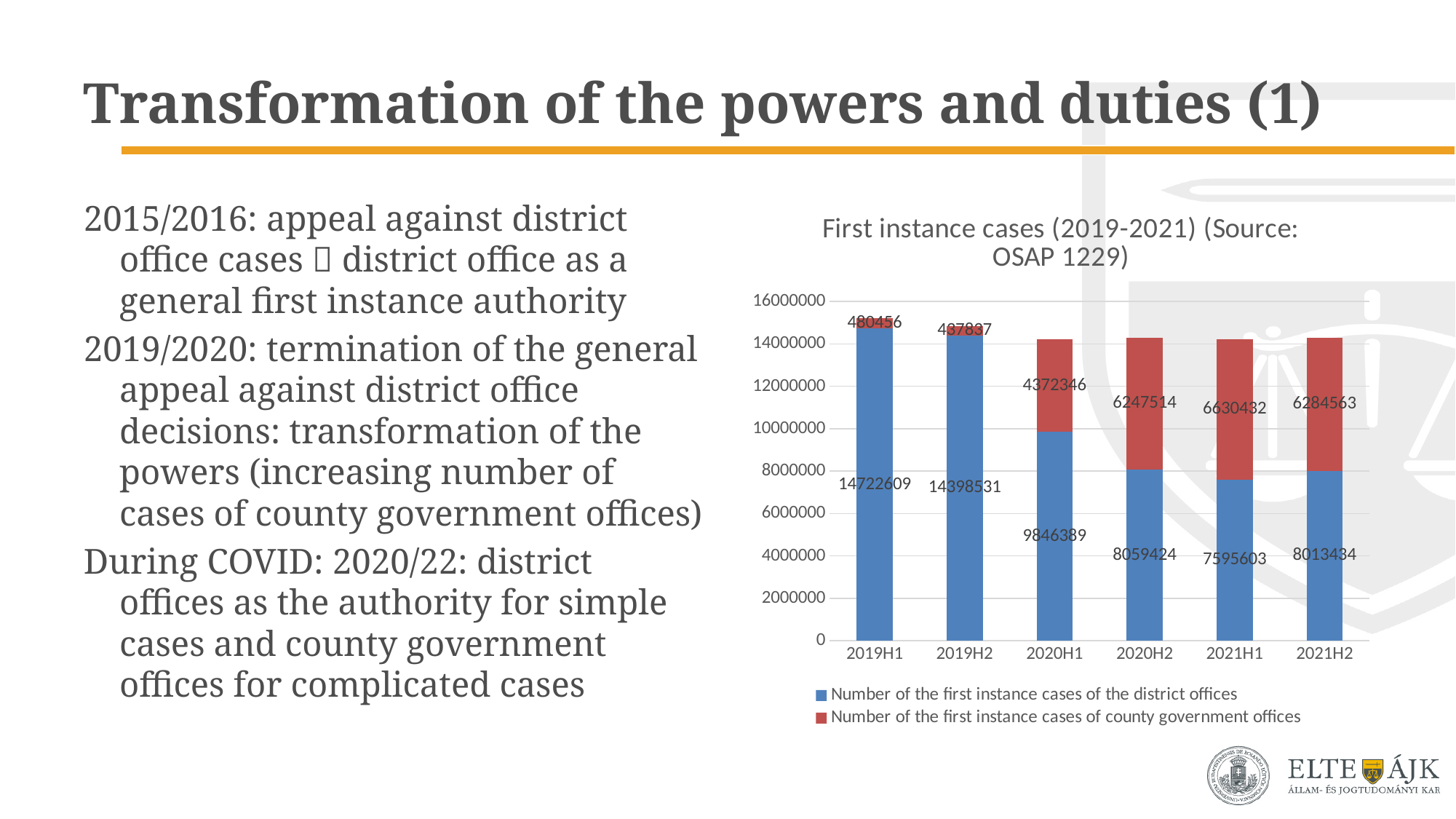
How many series does the chart's legend list? 2 What is the difference between the district offices' first instance cases in 2020H2 and 2021H2? 45990 In which period is the number of first instance cases of the district offices highest? 2019H1 Is the number of first instance cases of the district offices in 2021H1 greater or less than 8000000? less What is the number of first instance cases of the district offices in 2020H1? 9846389 In which period is the number of first instance cases of county government offices highest? 2021H1 How many periods are shown on the x axis of the chart? 6 Which period has more first instance cases of county government offices, 2020H2 or 2021H2? 2021H2 In which period is the number of first instance cases of the district offices lowest? 2021H1 What is the total number of first instance cases (district offices plus county government offices) in 2020H2? 14306938 What is the number of first instance cases of county government offices in 2021H1? 6630432 What kind of chart is shown on the slide? stacked bar chart